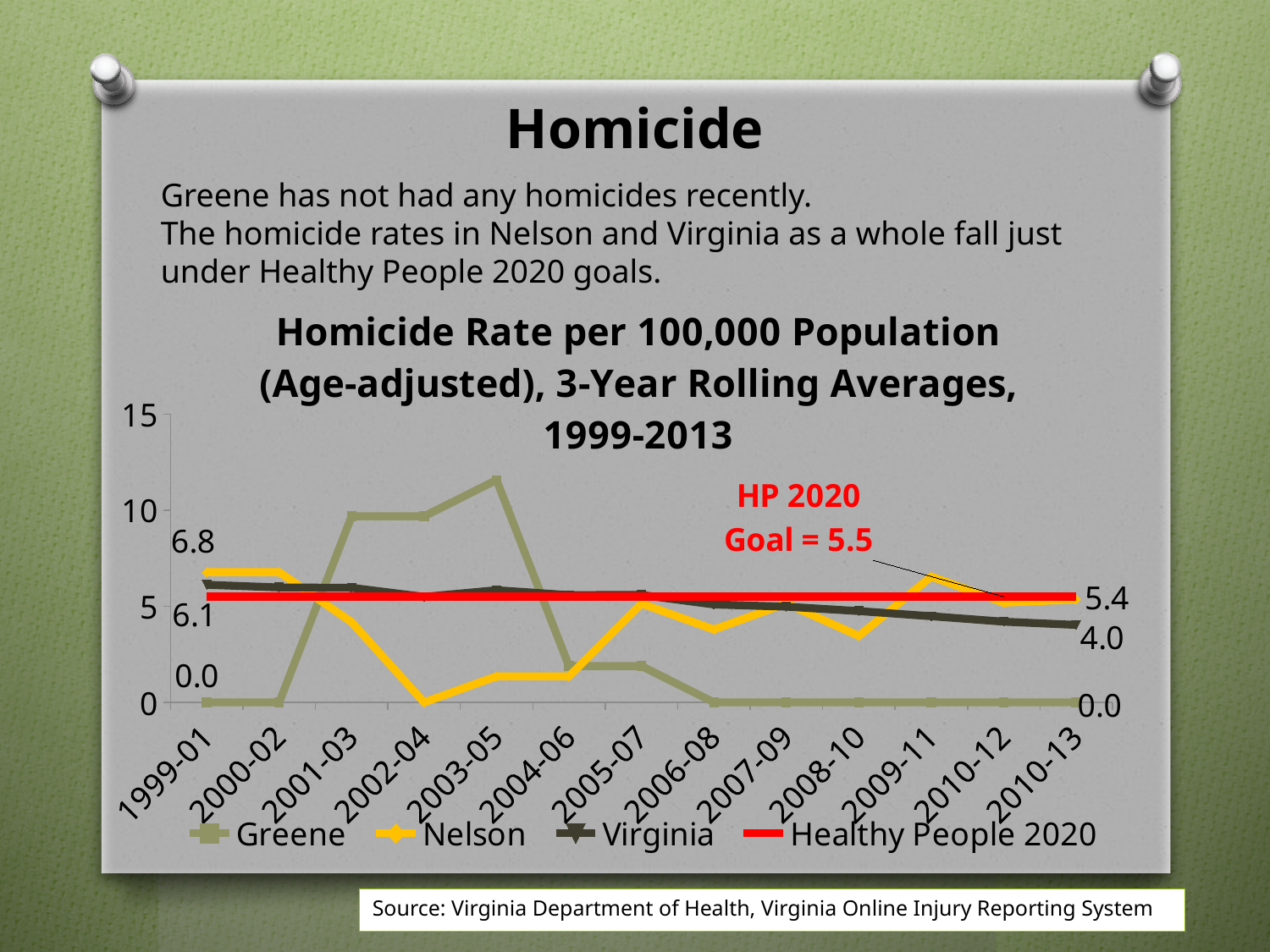
Which is higher in 2010-13, Nelson or Virginia? Nelson What is the homicide rate for Nelson in 1999-01? 6.8 What is the homicide rate for Virginia in 1999-01? 6.1 What is the homicide rate for Nelson in 2010-13? 5.4 What is the homicide rate for Greene in 2010-13? 0.0 How many time periods are shown on the x axis? 13 By how much did Virginia's homicide rate fall from 1999-01 to 2010-13? 2.1 What is the homicide rate for Virginia in 2010-13? 4.0 How many series does the legend list? 4 Is the value for Greene in 2003-05 greater or less than 10? greater What type of chart is shown on the slide? Line chart What is the HP 2020 goal value shown on the chart? 5.5